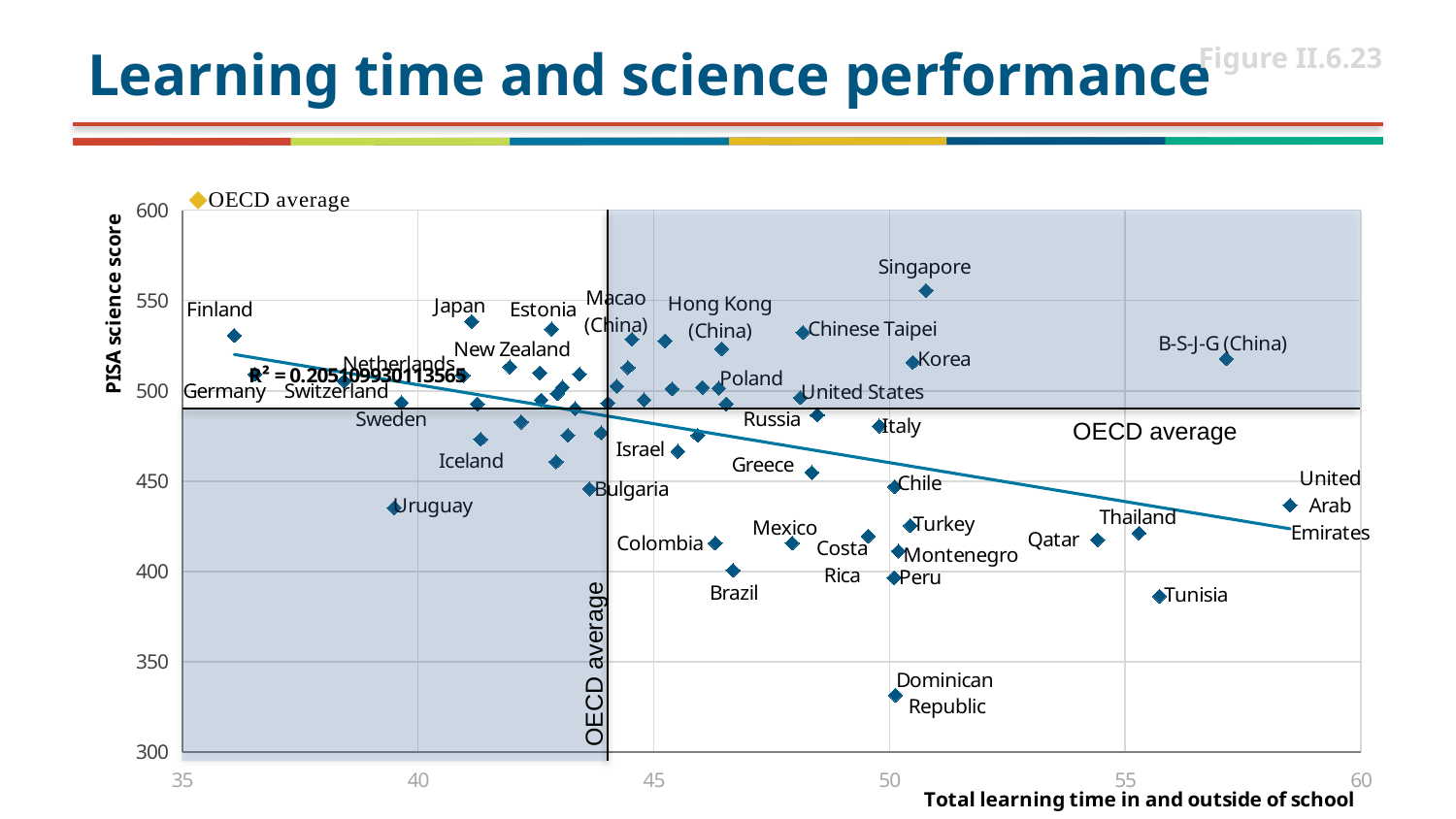
Which country has the lowest PISA science score on the chart? Dominican Republic Which has the higher PISA science score, Korea or Chile? Korea What R² value is printed on the chart? R² = 0.205109930113565 Does the trend line show PISA science scores rising or falling as total learning time increases? falling Which has the higher PISA science score, Finland or Uruguay? Finland Is the PISA science score for the Dominican Republic greater or less than 350? less Is the PISA science score for Singapore greater or less than 550? greater What kind of chart is shown on the slide? scatter plot Is the PISA science score for Tunisia greater or less than 400? less Which country has the highest PISA science score on the chart? Singapore Which country has the highest total learning time in and outside of school on the chart? United Arab Emirates